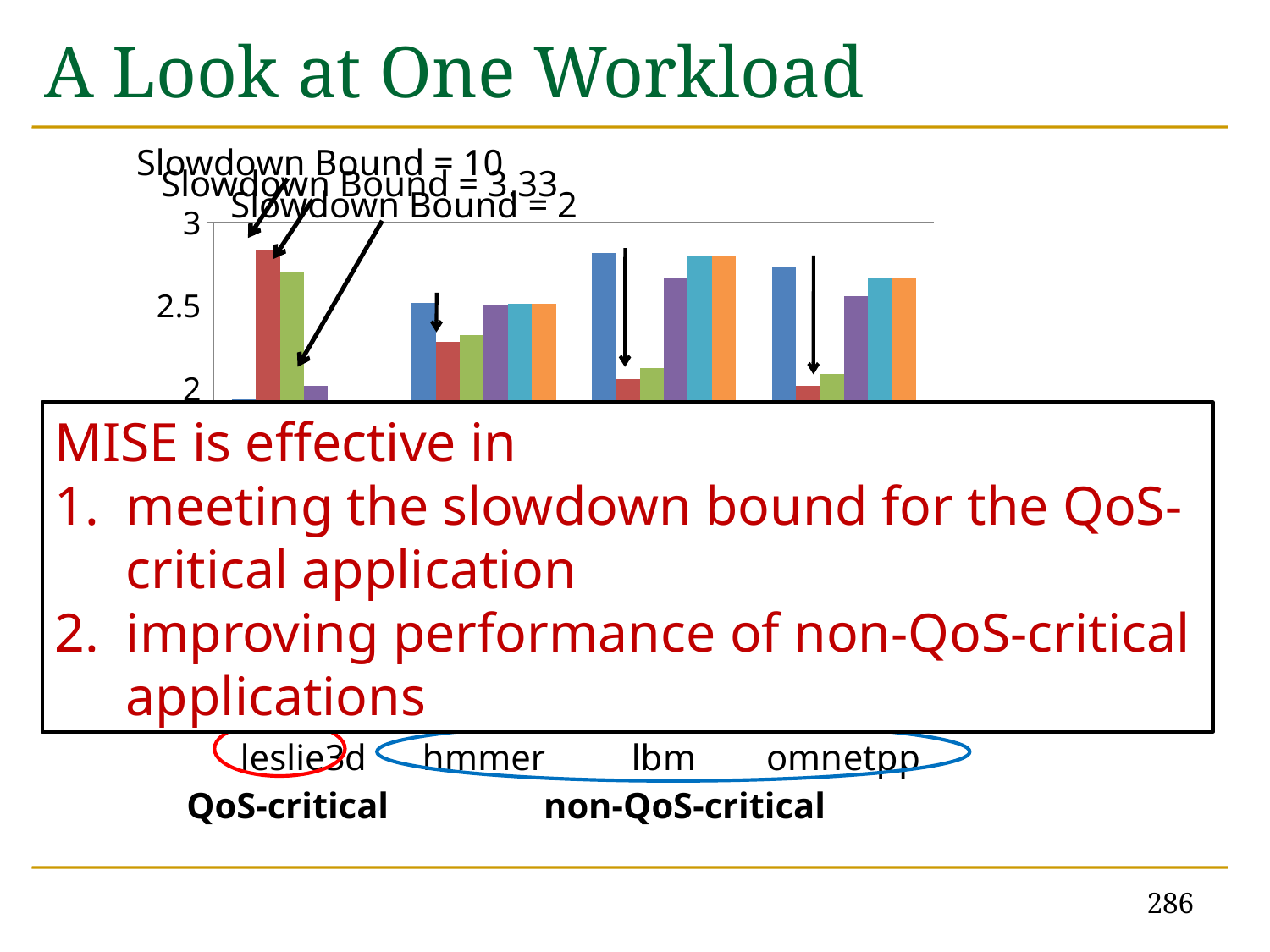
Is the red bar for lbm greater or less than 2.5? less Is the tallest bar for omnetpp greater or less than 2.5? greater Is the red bar for omnetpp greater or less than 2.5? less Which applications on the x axis are grouped as non-QoS-critical? hmmer, lbm, omnetpp What kind of chart is shown on the slide? bar chart Which application on the x axis is labelled as QoS-critical? leslie3d How many application categories are labelled on the x axis of the chart? 4